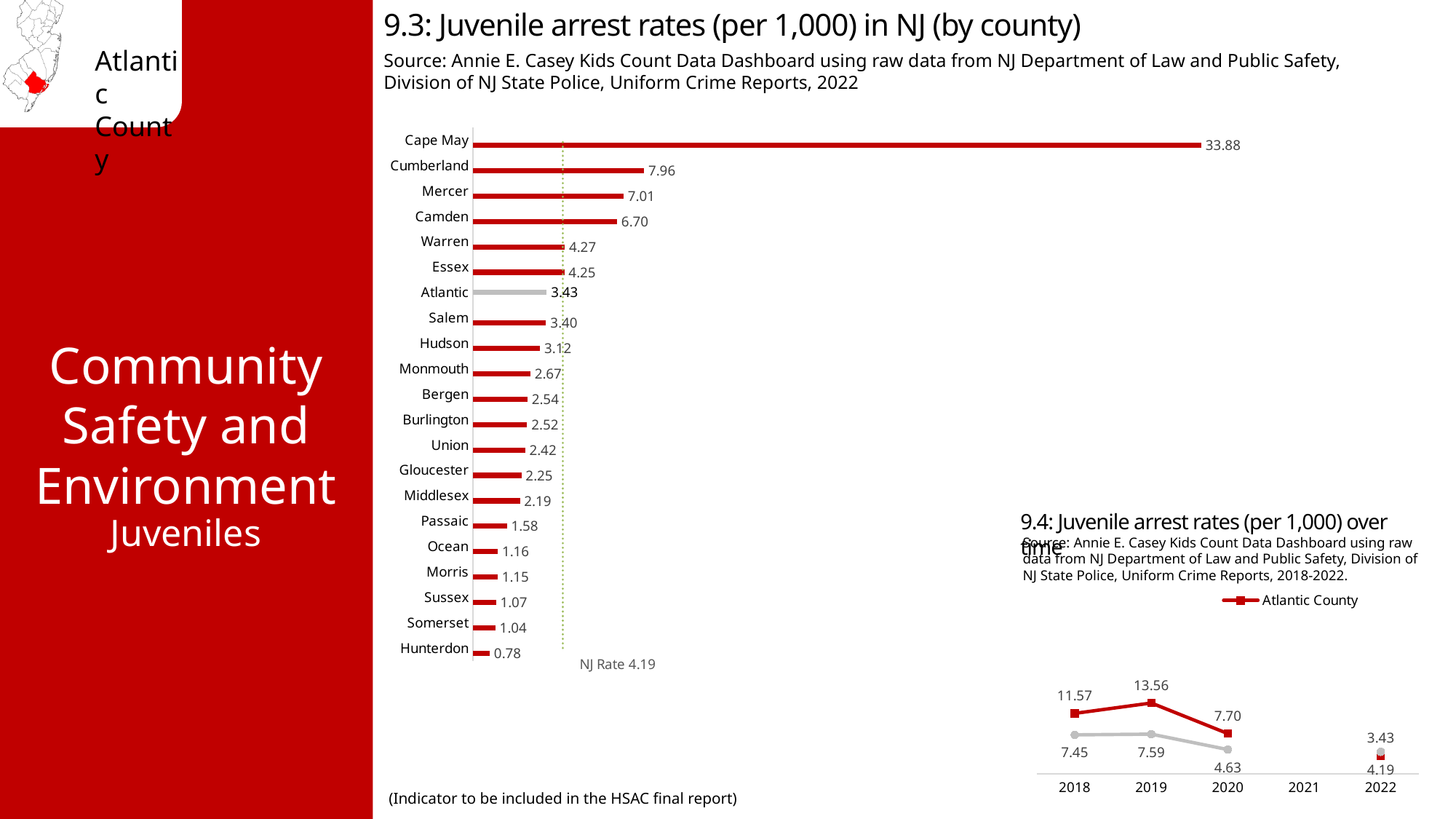
In the chart '9.3: Juvenile arrest rates (per 1,000) in NJ (by county)', what is the difference between the rates for Mercer and Camden? 0.31 In the chart '9.3: Juvenile arrest rates (per 1,000) in NJ (by county)', what NJ rate is marked by the dotted reference line? 4.19 In the chart '9.4: Juvenile arrest rates (per 1,000) over time', in which year is the Atlantic County rate highest? 2019 In the chart '9.3: Juvenile arrest rates (per 1,000) in NJ (by county)', which county has the lowest juvenile arrest rate? Hunterdon In the chart '9.4: Juvenile arrest rates (per 1,000) over time', what is the difference between the Atlantic County rate in 2018 and in 2022? 8.14 In the chart '9.3: Juvenile arrest rates (per 1,000) in NJ (by county)', which county has the highest juvenile arrest rate? Cape May In the chart '9.3: Juvenile arrest rates (per 1,000) in NJ (by county)', what is the value for Atlantic? 3.43 In the chart '9.3: Juvenile arrest rates (per 1,000) in NJ (by county)', which has a higher rate, Warren or Hudson? Warren In the chart '9.4: Juvenile arrest rates (per 1,000) over time', what is the Atlantic County value for 2019? 13.56 In the chart '9.3: Juvenile arrest rates (per 1,000) in NJ (by county)', how many counties are shown? 21 What kind of chart is '9.3: Juvenile arrest rates (per 1,000) in NJ (by county)'? Bar chart In the chart '9.3: Juvenile arrest rates (per 1,000) in NJ (by county)', what is the juvenile arrest rate for Cumberland? 7.96